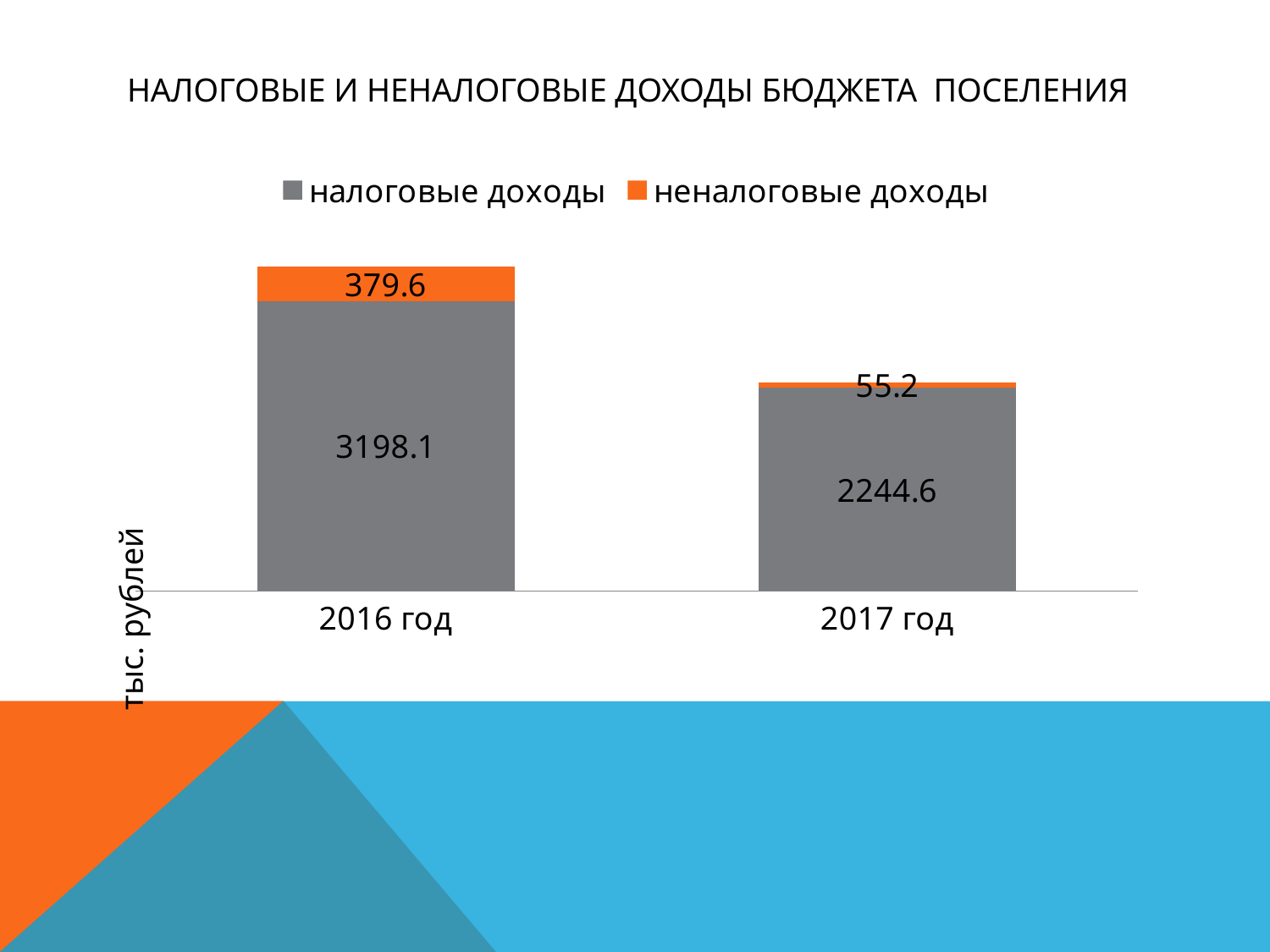
Which year has the higher value of налоговые доходы? 2016 год What is the value of неналоговые доходы for 2016 год? 379.6 What is the difference between налоговые доходы in 2016 год and 2017 год? 953.5 Which year has the lower value of неналоговые доходы? 2017 год What is the value of налоговые доходы for 2016 год? 3198.1 What is the total of the stacked bar for 2017 год? 2299.8 What is the total of the stacked bar for 2016 год? 3577.7 What is the value of налоговые доходы for 2017 год? 2244.6 What kind of chart is shown on the slide? Stacked bar chart What is the difference between неналоговые доходы in 2016 год and 2017 год? 324.4 How many series does the legend list? 2 What is the value of неналоговые доходы for 2017 год? 55.2